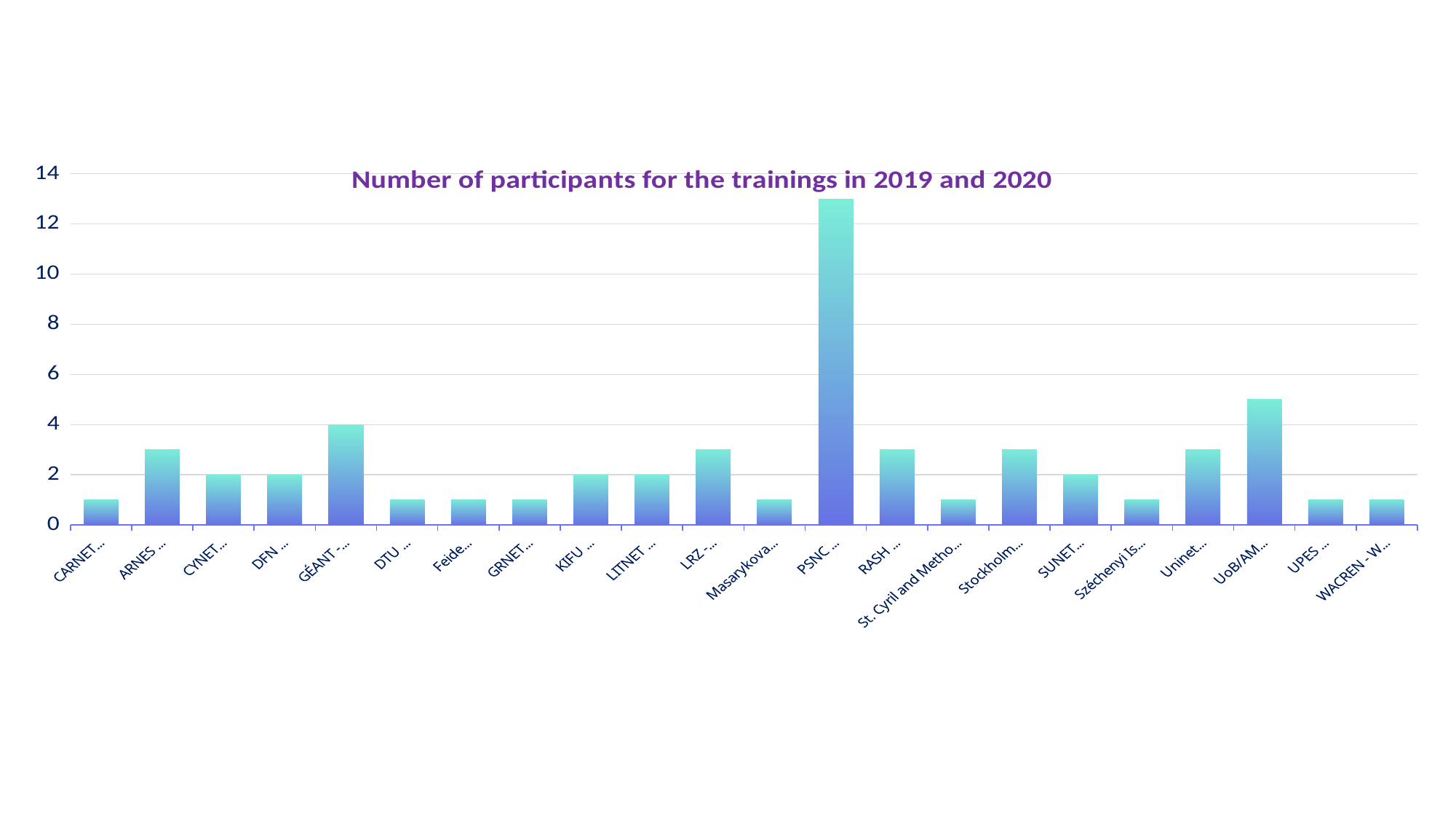
What is the value for CYNET? 2 Is the value for UoB/AM greater or less than 4? greater How many categories are shown on the x axis? 22 What is the value for GÉANT? 4 Is the value for PSNC greater or less than 12? greater Is the value for CARNET greater or less than 2? less What kind of chart is shown on the slide? bar chart What is the value for SUNET? 2 What is the title of the chart? Number of participants for the trainings in 2019 and 2020 Which category has the highest number of participants? PSNC Which is larger, the value for GÉANT or the value for DFN? GÉANT What is the difference between the values for GÉANT and KIFU? 2